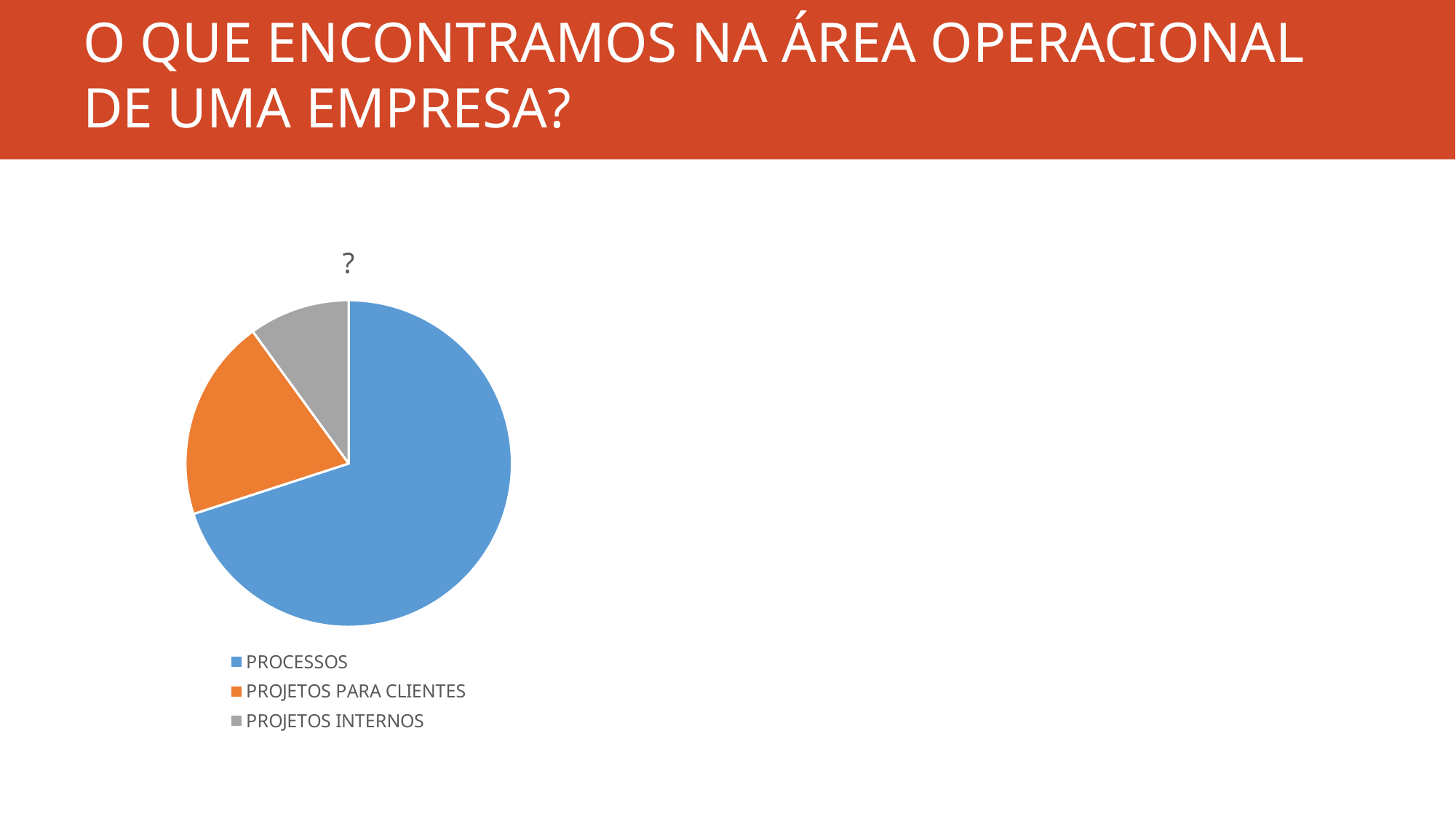
Which category has the smallest slice of the pie chart? PROJETOS INTERNOS What is the title shown above the pie chart? ? What colour is the PROJETOS PARA CLIENTES slice? orange Does the PROCESSOS slice take up more or less than half of the pie? more How many slices does the pie chart have? 3 Which slice is larger, PROJETOS PARA CLIENTES or PROJETOS INTERNOS? PROJETOS PARA CLIENTES Which category has the largest slice of the pie chart? PROCESSOS What kind of chart is shown on the slide? pie chart Which slice is larger, PROCESSOS or PROJETOS PARA CLIENTES? PROCESSOS